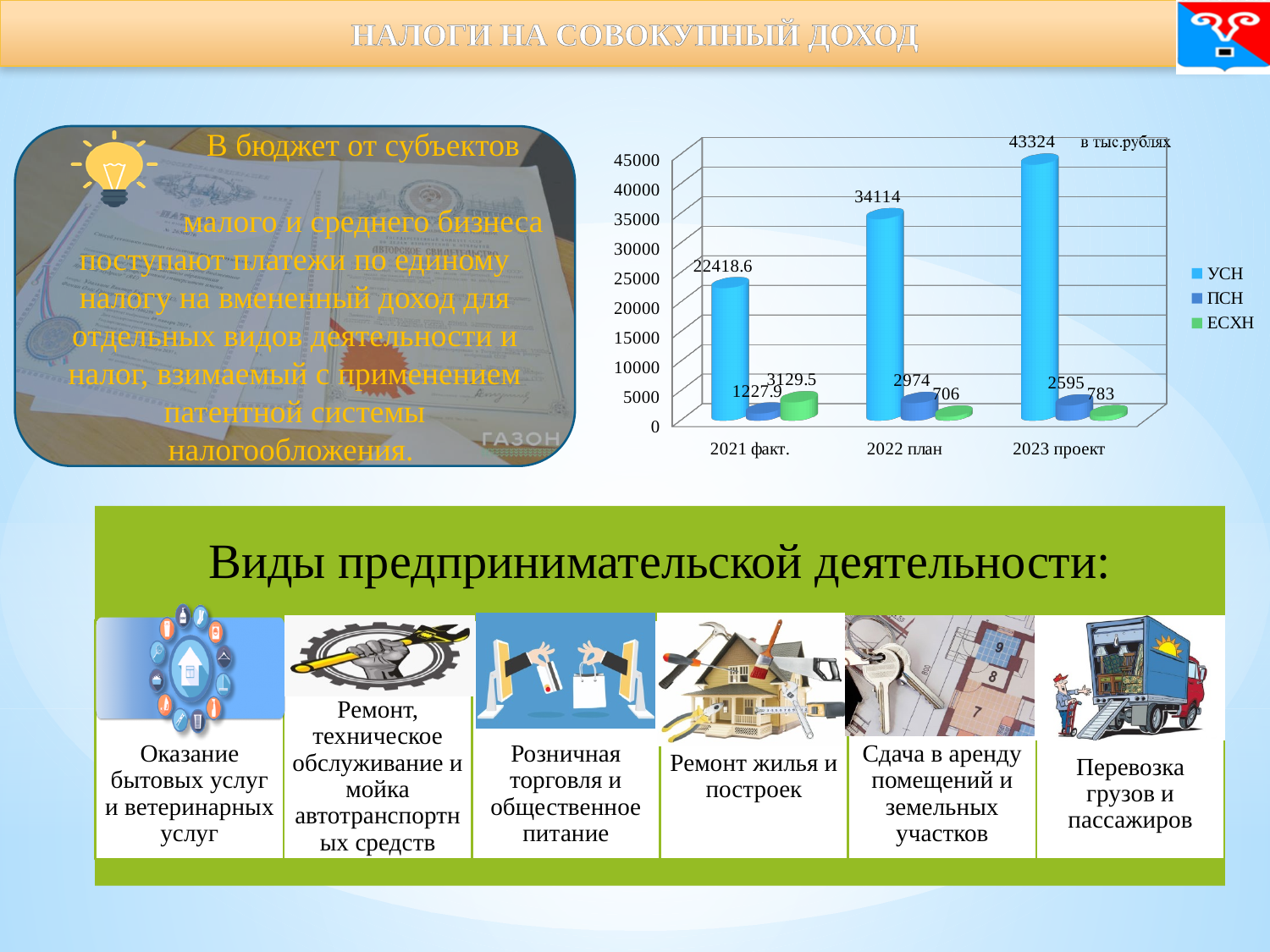
What is the difference between the УСН values for 2023 проект and 2022 план? 9210 How many series does the legend list? 3 Does the УСН value rise or fall from 2021 факт. to 2023 проект? rise What kind of chart is shown? bar chart Which is larger: ПСН in 2022 план or ПСН in 2023 проект? ПСН in 2022 план In which year is the УСН value highest? 2023 проект What is the value for ПСН in 2021 факт.? 1227.9 In which year is the ЕСХН value lowest? 2022 план What is the value for ЕСХН in 2022 план? 706 What is the value for УСН in 2023 проект? 43324 How many categories are shown on the x axis? 3 What is the value for УСН in 2021 факт.? 22418.6